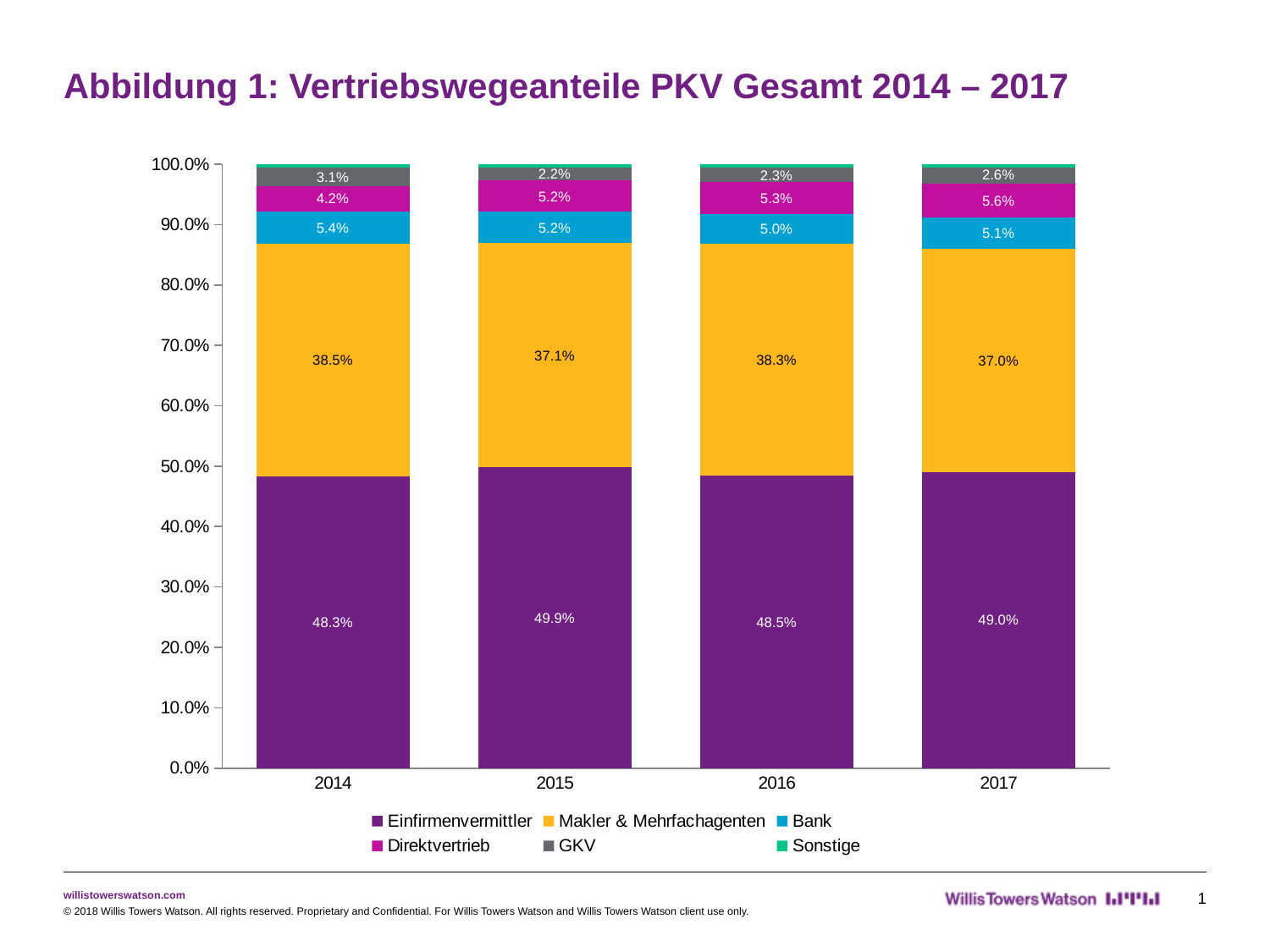
What is the share of GKV in 2014? 3.1% What is the share of Makler & Mehrfachagenten in 2017? 37.0% What is the share of Direktvertrieb in 2016? 5.3% In which year is the share of GKV lowest? 2015 What is the share of Einfirmenvermittler in 2015? 49.9% What is the share of Bank in 2014? 5.4% Which is larger: the Direktvertrieb share in 2014 or in 2017? 2017 What kind of chart is shown on the slide? Stacked bar chart What is the difference between the Makler & Mehrfachagenten share in 2014 and in 2015? 1.4% In which year is the share of Einfirmenvermittler highest? 2015 How many series does the legend list? 6 How many years are shown on the x axis? 4